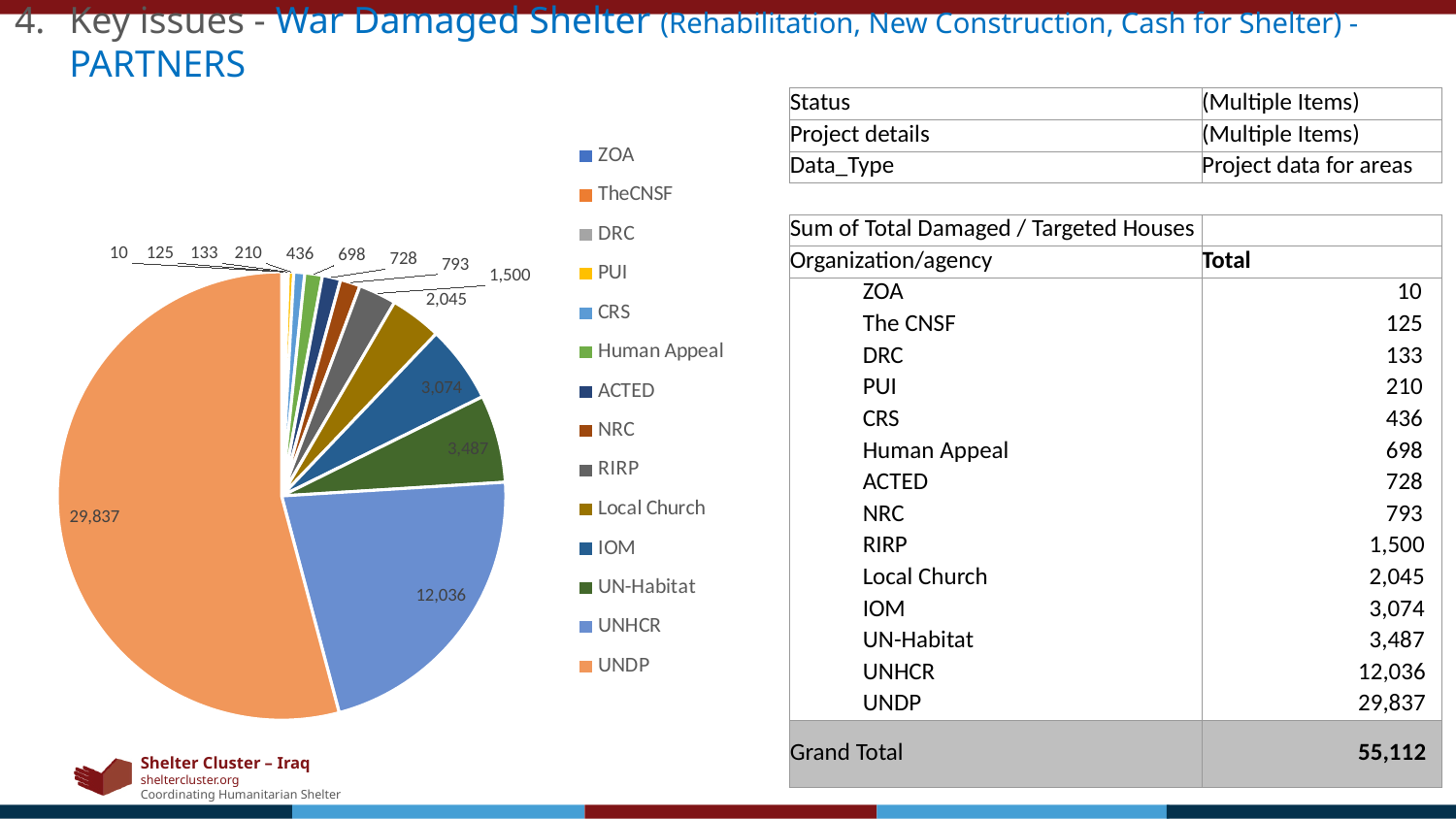
What value is shown for RIRP in the pie chart? 1,500 What kind of chart is shown on the slide? pie chart What is the difference between the UNDP and UNHCR values in the pie chart? 17,801 Which organization has the largest slice in the pie chart? UNDP What value is shown for UNDP in the pie chart? 29,837 Which legend entry in the pie chart is shown in yellow? PUI Which is larger in the pie chart, the value for IOM or the value for UN-Habitat? UN-Habitat What is the total of all the values shown in the pie chart? 55,112 Which organization has the smallest slice in the pie chart? ZOA What value is shown for UN-Habitat in the pie chart? 3,487 What value is shown for UNHCR in the pie chart? 12,036 How many slices (organizations) does the pie chart have? 14